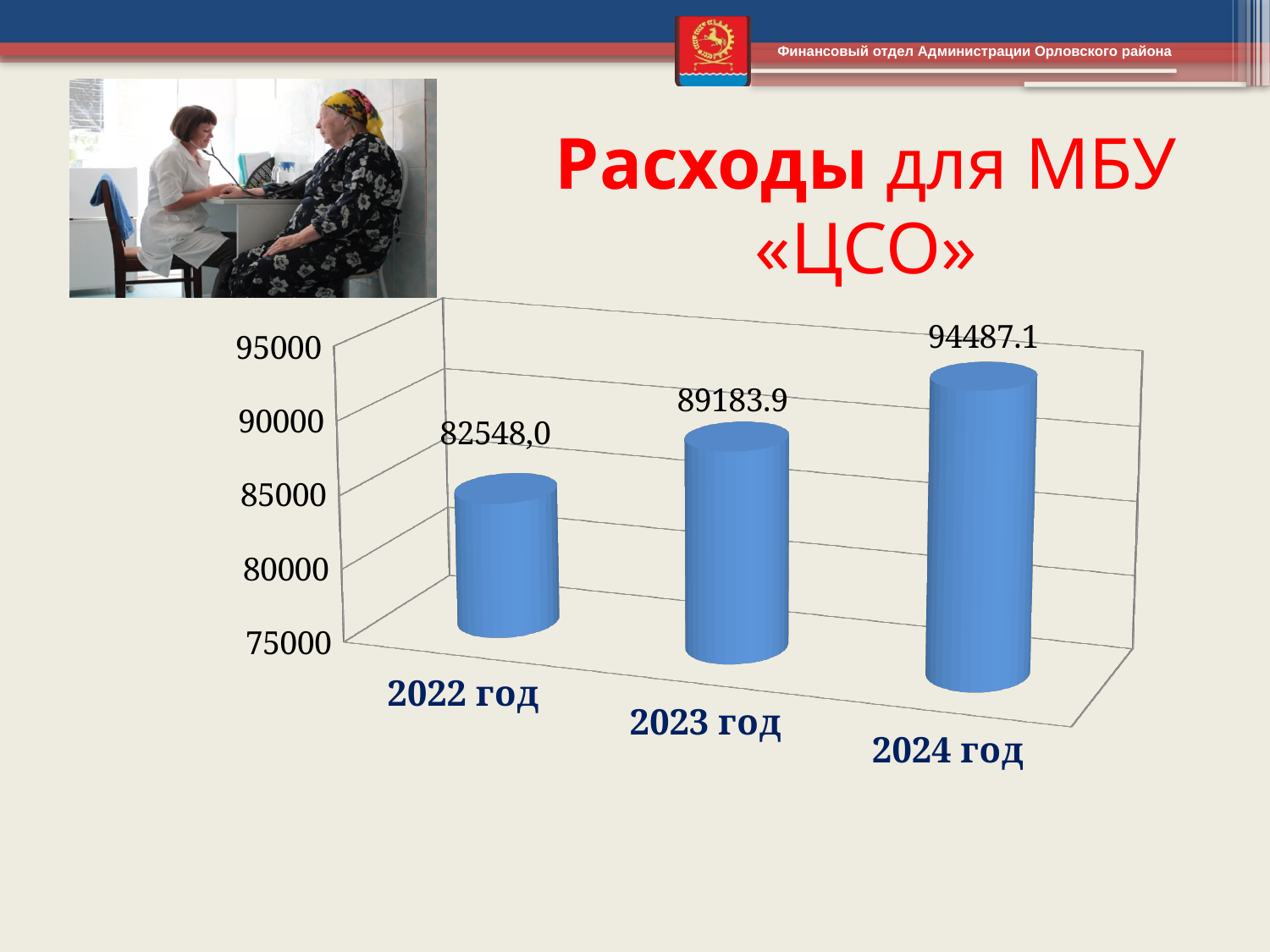
What kind of chart is shown on the slide? bar chart Is the value for 2024 год greater or less than 90000? greater What is the value shown for 2023 год? 89183.9 Which is larger, the value for 2022 год or the value for 2023 год? 2023 год Which year has the lowest value? 2022 год How many years are shown on the chart? 3 What is the difference between the values for 2024 год and 2023 год? 5303.2 Do the values rise or fall from 2022 год to 2024 год? rise What is the value shown for 2022 год? 82548,0 Is the value for 2022 год greater or less than 80000? greater Which year has the highest value? 2024 год What is the value shown for 2024 год? 94487.1